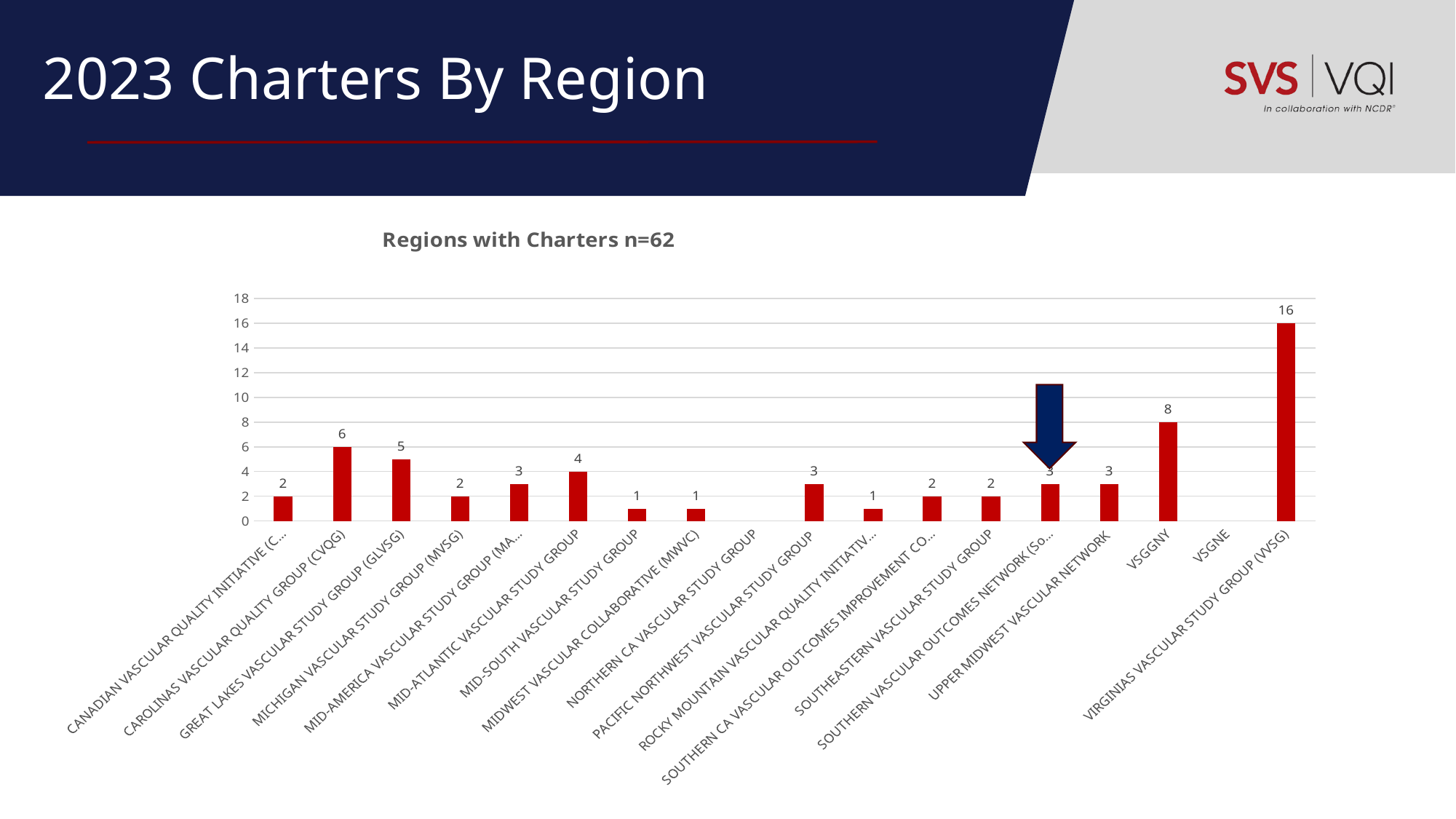
What is the value for MID-ATLANTIC VASCULAR STUDY GROUP? 4 What is the title of the chart? Regions with Charters n=62 What is the value for CAROLINAS VASCULAR QUALITY GROUP (CVQG)? 6 Which region has the highest number of charters? VIRGINIAS VASCULAR STUDY GROUP (VVSG) What is the value for VSGGNY? 8 Which region's bar is marked with a dark blue arrow? SOUTHERN VASCULAR OUTCOMES NETWORK Which has a larger value, GREAT LAKES VASCULAR STUDY GROUP (GLVSG) or MICHIGAN VASCULAR STUDY GROUP (MVSG)? GREAT LAKES VASCULAR STUDY GROUP (GLVSG) What kind of chart is shown on the slide? bar chart How many region categories are shown on the x axis? 18 What is the value for MID-SOUTH VASCULAR STUDY GROUP? 1 How many charters does VIRGINIAS VASCULAR STUDY GROUP (VVSG) have? 16 What is the difference between the values for VIRGINIAS VASCULAR STUDY GROUP (VVSG) and VSGGNY? 8